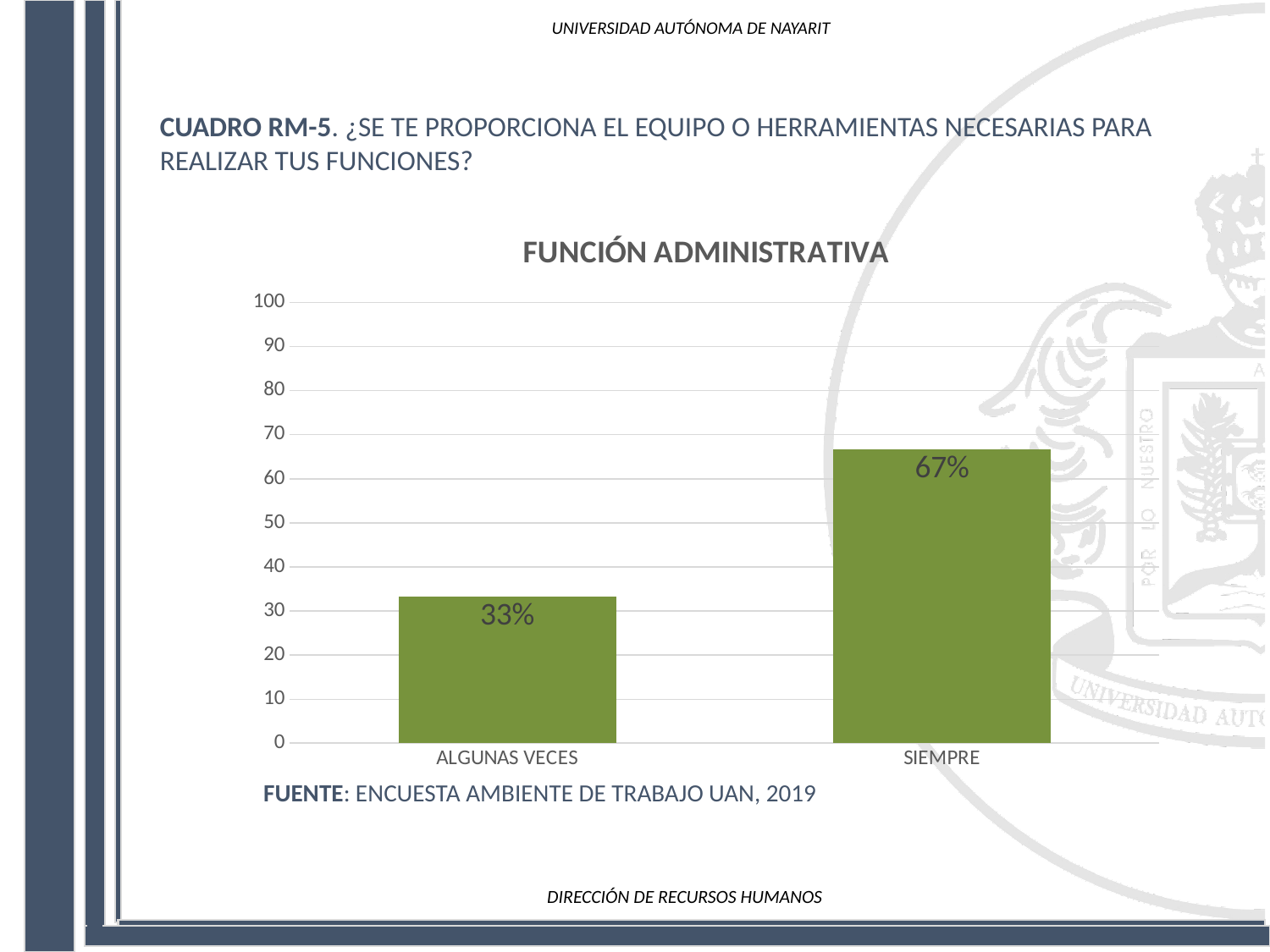
What is the value for SIEMPRE? 67% Is the value for SIEMPRE greater or less than 50? greater Which category has the highest value? SIEMPRE What is the maximum value shown on the y axis? 100 Which is larger, the value for ALGUNAS VECES or the value for SIEMPRE? SIEMPRE What is the difference between the values for SIEMPRE and ALGUNAS VECES? 34% What kind of chart is shown on the slide? bar chart What is the value for ALGUNAS VECES? 33% What is the title of the chart? FUNCIÓN ADMINISTRATIVA How many categories are shown on the x axis? 2 Is the value for ALGUNAS VECES greater or less than 40? less Which category has the lowest value? ALGUNAS VECES